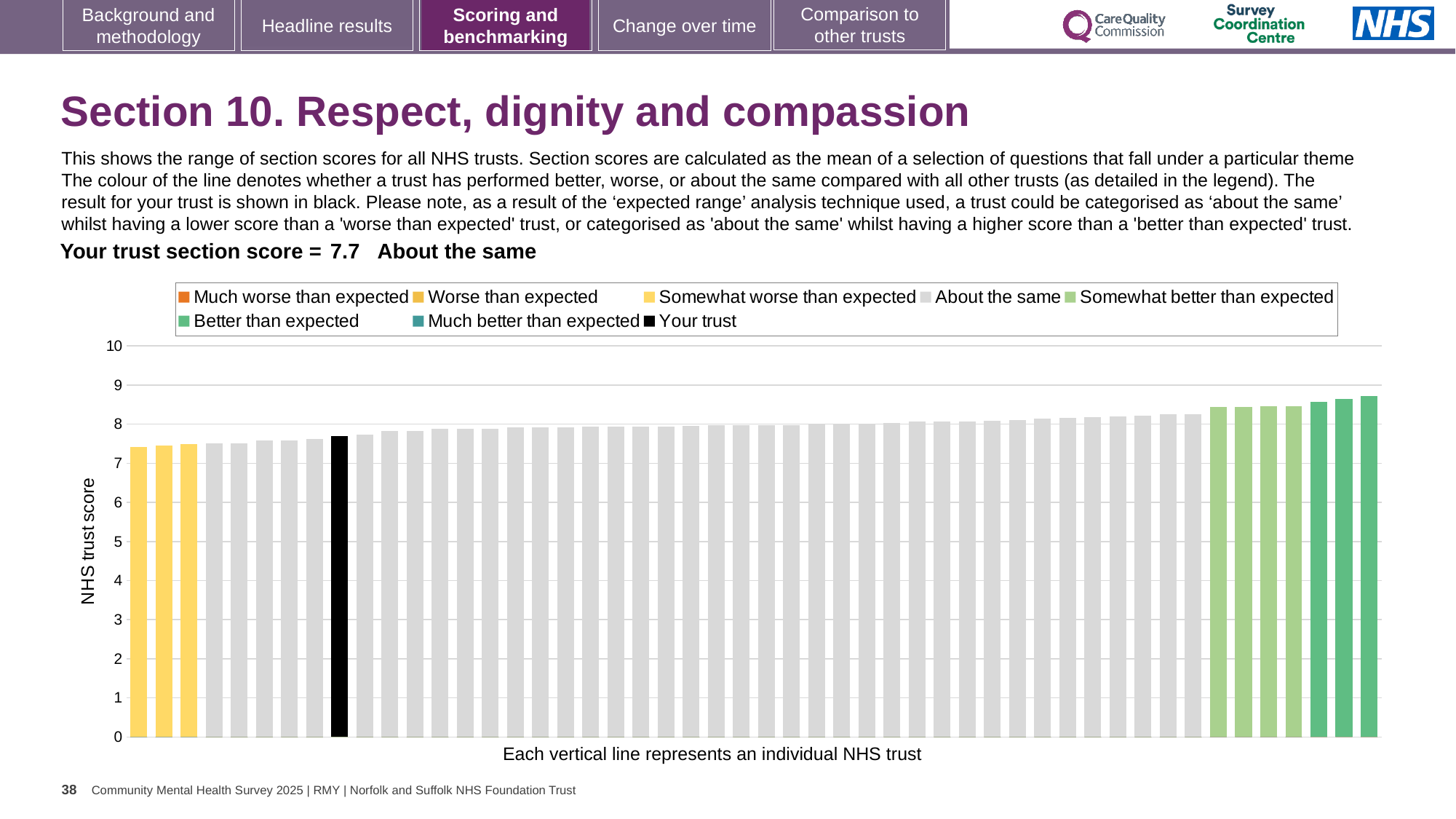
Is the value of the leftmost bar greater or less than 7? greater What kind of chart is shown on the slide? bar chart What is the section score for your trust shown on the slide? 7.7 How many bars are coloured yellow? 3 Do the bar values rise or fall from left to right along the x axis? rise Is the value for your trust (the black bar) greater or less than 8? less Is the value for your trust (the black bar) greater or less than 7? greater How many entries does the chart legend list? 8 Which bar is larger, the leftmost bar or the rightmost bar? the rightmost bar What is the label on the vertical axis of the chart? NHS trust score Which category is your trust placed in for this section? About the same